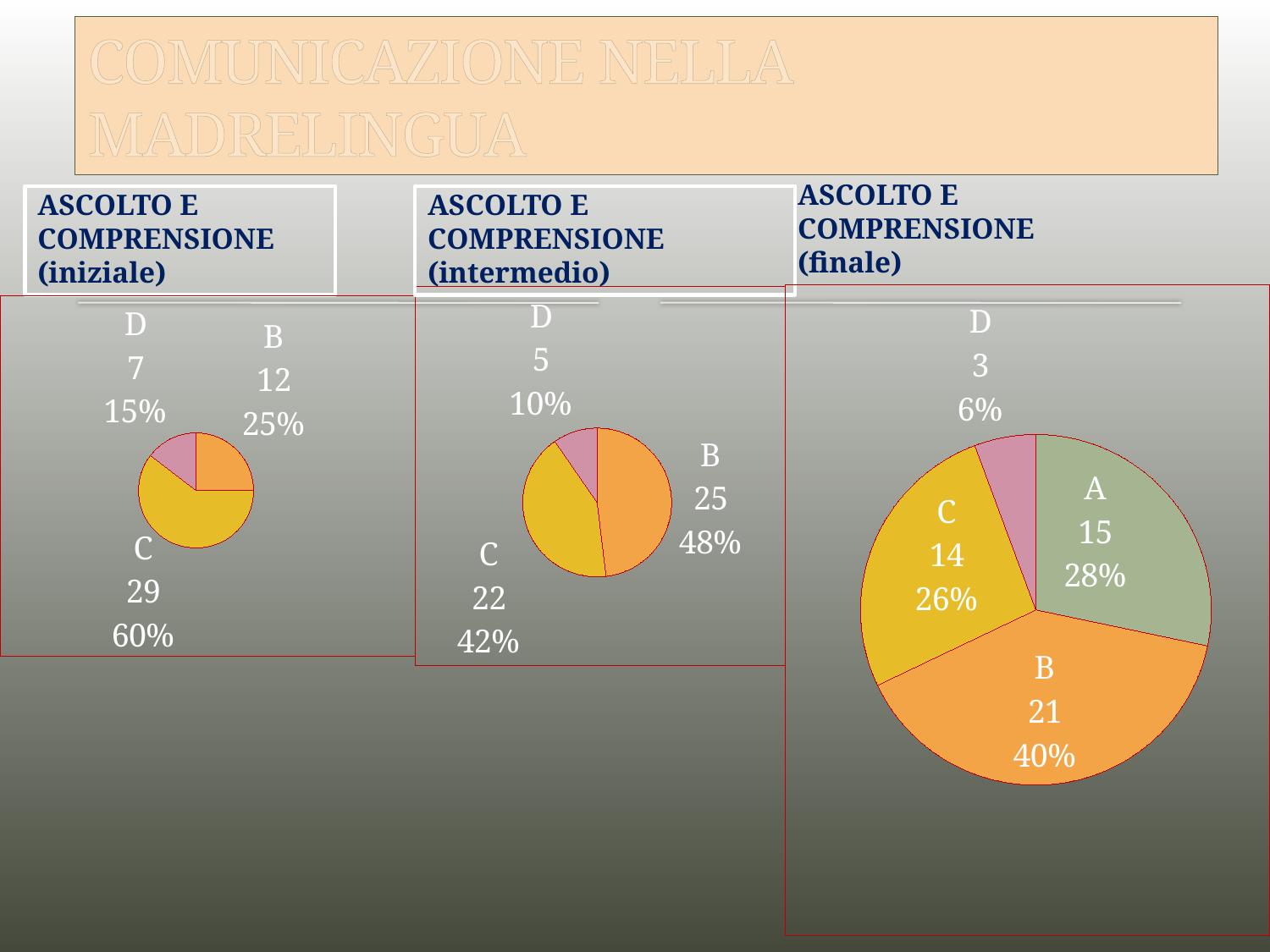
In the 'ASCOLTO E COMPRENSIONE (intermedio)' chart, what is the difference between the values for B and C? 3 In the 'ASCOLTO E COMPRENSIONE (iniziale)' chart, which category has the largest slice? C In the 'ASCOLTO E COMPRENSIONE (finale)' chart, what value is shown for category D? 3 How many categories does the 'ASCOLTO E COMPRENSIONE (finale)' chart show? 4 In the 'ASCOLTO E COMPRENSIONE (finale)' chart, which is larger, the value for B or the value for C? B In the 'ASCOLTO E COMPRENSIONE (iniziale)' chart, what percentage share does category B have? 25% In the 'ASCOLTO E COMPRENSIONE (intermedio)' chart, which category has the smallest slice? D What kind of chart is used for 'ASCOLTO E COMPRENSIONE (iniziale)'? Pie chart In the 'ASCOLTO E COMPRENSIONE (finale)' chart, what percentage share does category A have? 28% How many categories does the 'ASCOLTO E COMPRENSIONE (iniziale)' chart show? 3 In the 'ASCOLTO E COMPRENSIONE (intermedio)' chart, what value is shown for category B? 25 In the 'ASCOLTO E COMPRENSIONE (iniziale)' chart, what value is shown for category C? 29